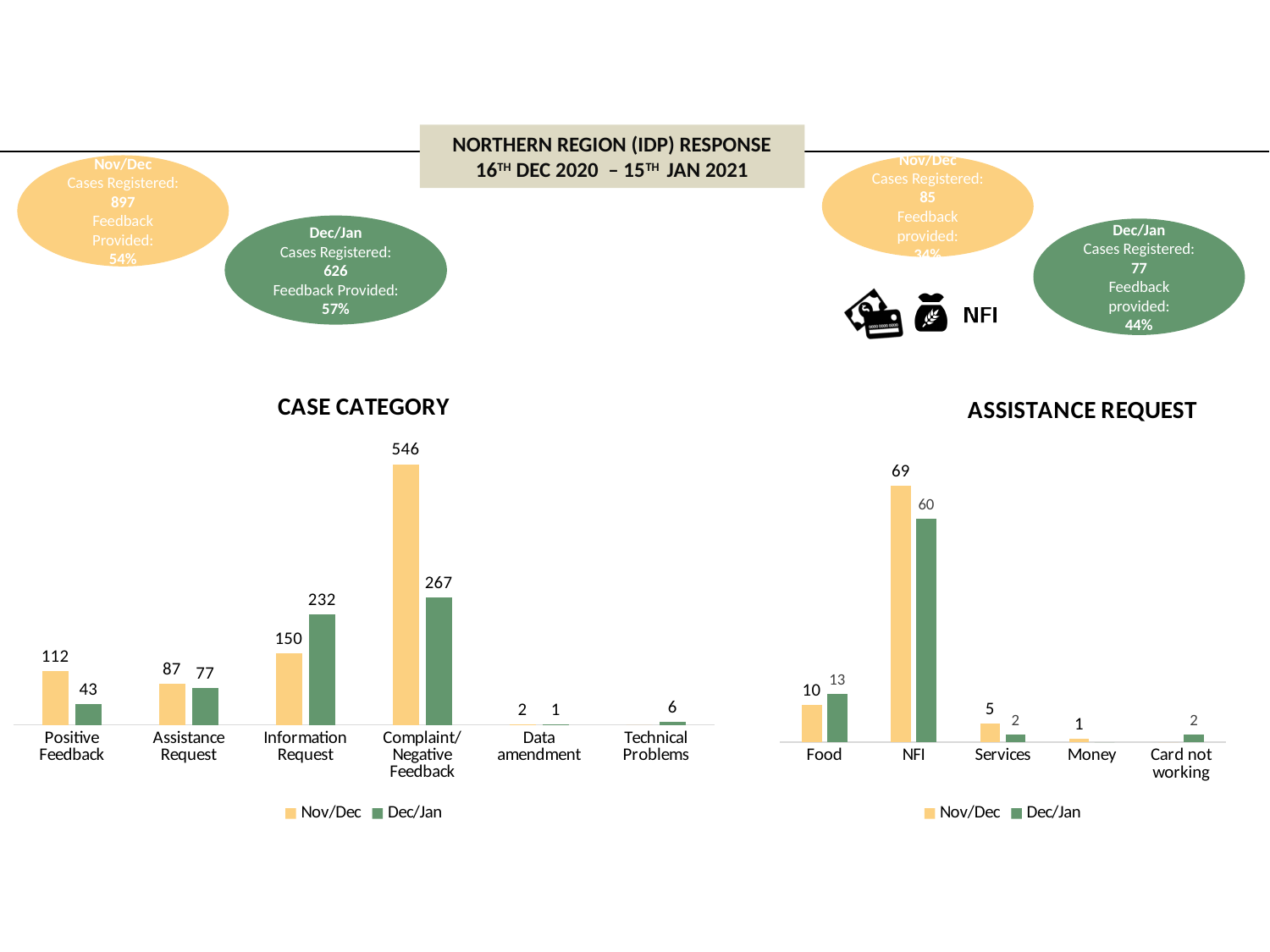
In the CASE CATEGORY chart, what is the Dec/Jan value for Information Request? 232 What are the two series named in the legend of the CASE CATEGORY chart? Nov/Dec and Dec/Jan How many categories are shown on the x axis of the CASE CATEGORY chart? 6 In the CASE CATEGORY chart, which is larger for Information Request: the Nov/Dec value or the Dec/Jan value? Dec/Jan What type of chart is the CASE CATEGORY chart? Bar chart In the CASE CATEGORY chart, what is the difference between the Nov/Dec and Dec/Jan values for Positive Feedback? 69 In the ASSISTANCE REQUEST chart, what is the Dec/Jan value for NFI? 60 In the CASE CATEGORY chart, which category has the highest Nov/Dec value? Complaint/Negative Feedback In the CASE CATEGORY chart, what is the Nov/Dec value for Complaint/Negative Feedback? 546 In the ASSISTANCE REQUEST chart, what is the difference between the Nov/Dec and Dec/Jan values for Food? 3 How many series does the legend of the ASSISTANCE REQUEST chart list? 2 In the ASSISTANCE REQUEST chart, which category has the highest Nov/Dec value? NFI